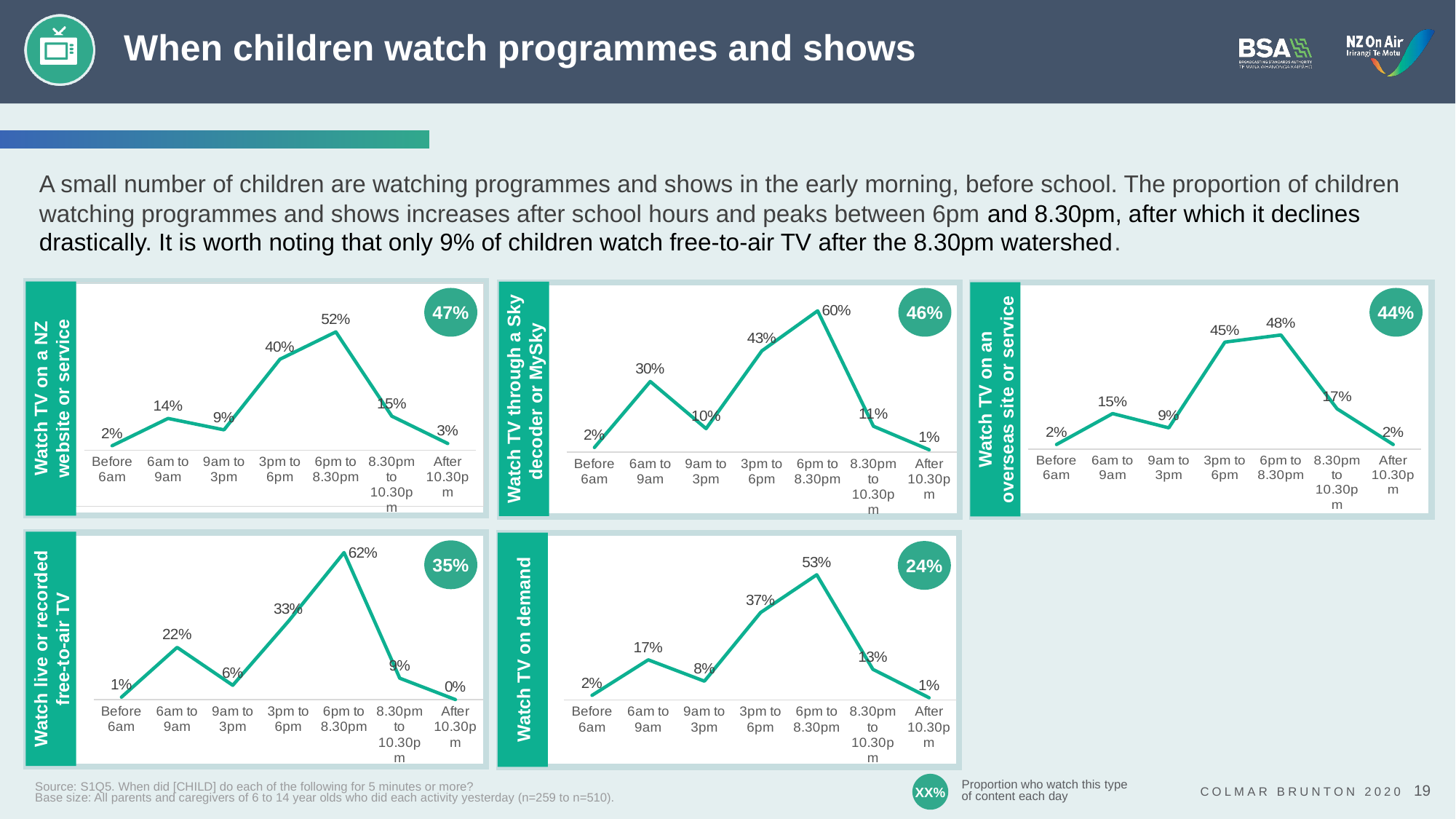
In the 'Watch live or recorded free-to-air TV' chart, what is the value for After 10.30pm? 0% In the 'Watch TV on demand' chart, what is the difference between the 3pm to 6pm value and the 9am to 3pm value? 29% In the 'Watch TV through a Sky decoder or MySky' chart, what is the value for 6am to 9am? 30% In the 'Watch live or recorded free-to-air TV' chart, do the values rise or fall from 6pm to 8.30pm to After 10.30pm? Fall In the 'Watch TV on demand' chart, what is the difference between the 6pm to 8.30pm value and the 8.30pm to 10.30pm value? 40% In the 'Watch TV on a NZ website or service' chart, what is the value for 6pm to 8.30pm? 52% In the 'Watch TV on an overseas site or service' chart, which is larger: the value for 3pm to 6pm or the value for 6pm to 8.30pm? 6pm to 8.30pm In the 'Watch TV on a NZ website or service' chart, which time slot has the lowest value? Before 6am In the 'Watch TV through a Sky decoder or MySky' chart, which time slot has the highest value? 6pm to 8.30pm What type of chart is used for 'Watch TV on demand'? Line chart How many time slots are shown on the x axis of the 'Watch live or recorded free-to-air TV' chart? 7 What is the proportion shown in the circle for the 'Watch TV on an overseas site or service' chart? 44%